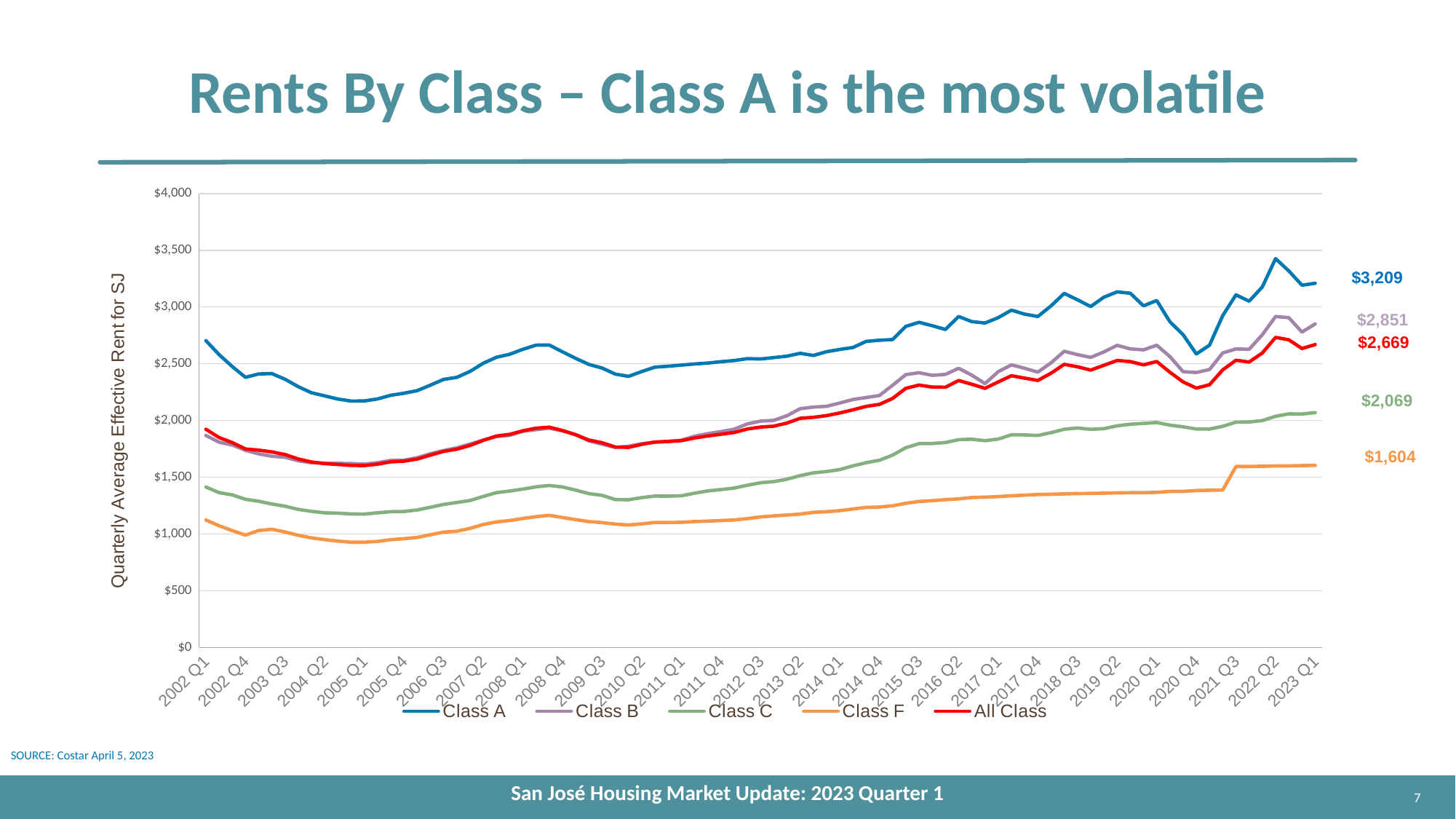
What is the difference between Class C and Class F at 2023 Q1? $465 What is the value for Class F at 2023 Q1? $1,604 What is the value for All Class at 2023 Q1? $2,669 What is the value for Class A at 2023 Q1? $3,209 Is the value for Class F at 2005 Q1 greater or less than $1,000? less Which series has the highest value at 2023 Q1? Class A What kind of chart is shown on the slide? line chart Which is larger at 2023 Q1, Class B or All Class? Class B How many series does the legend list? 5 What is the difference between Class A and Class B at 2023 Q1? $358 What is the value for Class B at 2023 Q1? $2,851 Which series has the lowest value at 2023 Q1? Class F